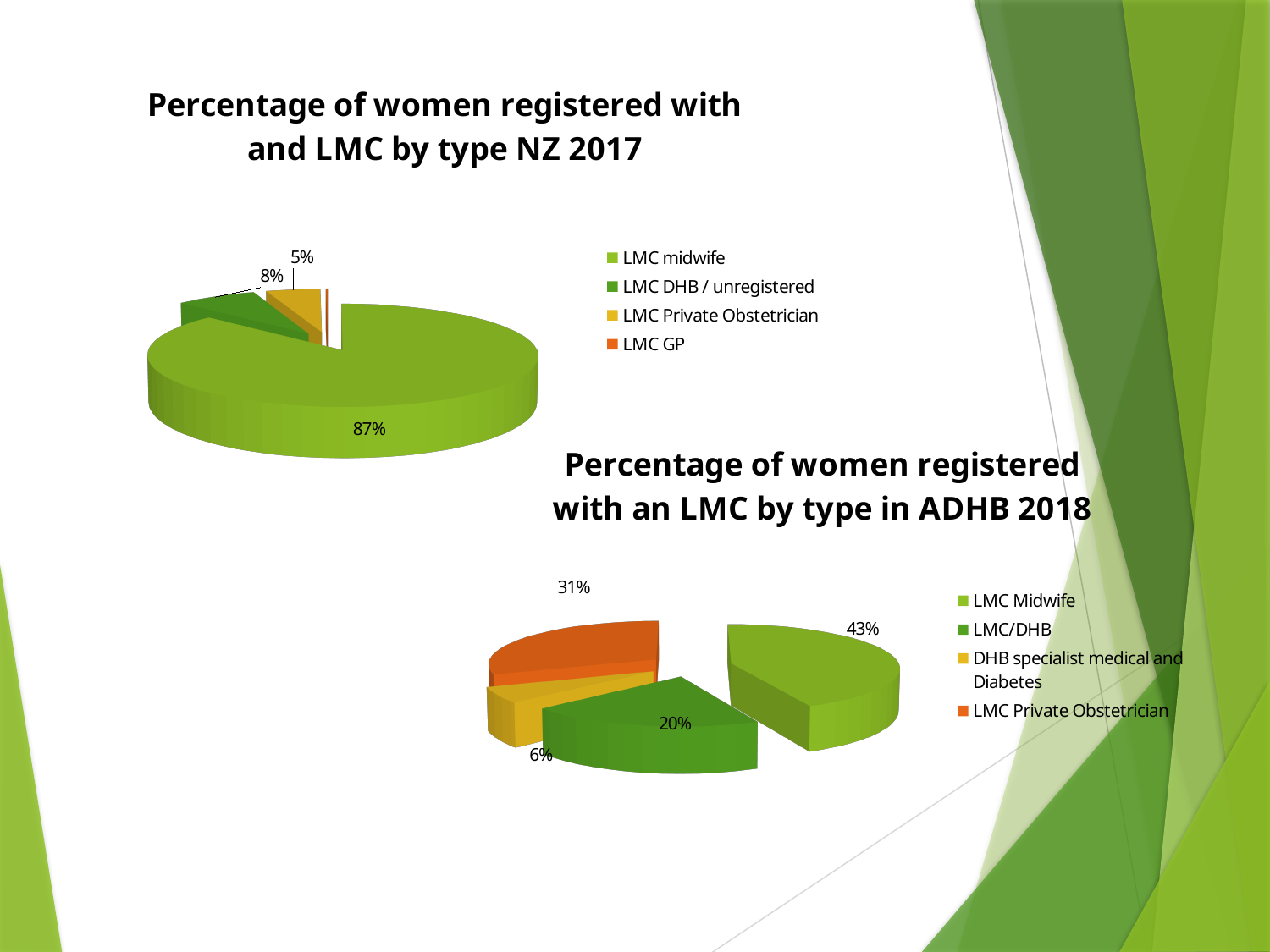
In the NZ 2017 chart, which category has the largest share? LMC midwife In the ADHB 2018 chart, what percentage is shown for LMC Private Obstetrician? 31% In the ADHB 2018 chart, what percentage is shown for DHB specialist medical and Diabetes? 6% In the ADHB 2018 chart, what is the difference between the LMC Midwife share and the LMC/DHB share? 23% In the 'Percentage of women registered with and LMC by type NZ 2017' chart, what percentage is shown for LMC midwife? 87% In the NZ 2017 chart, how many categories does the legend list? 4 What kind of chart is the 'Percentage of women registered with an LMC by type in ADHB 2018' chart? Pie chart In the ADHB 2018 chart, what percentage is shown for LMC Midwife? 43% In the NZ 2017 chart, what percentage is shown for LMC DHB / unregistered? 8% In the ADHB 2018 chart, which is larger: LMC/DHB or LMC Private Obstetrician? LMC Private Obstetrician In the ADHB 2018 chart, which category has the smallest share? DHB specialist medical and Diabetes In the NZ 2017 chart, what percentage is shown for LMC Private Obstetrician? 5%